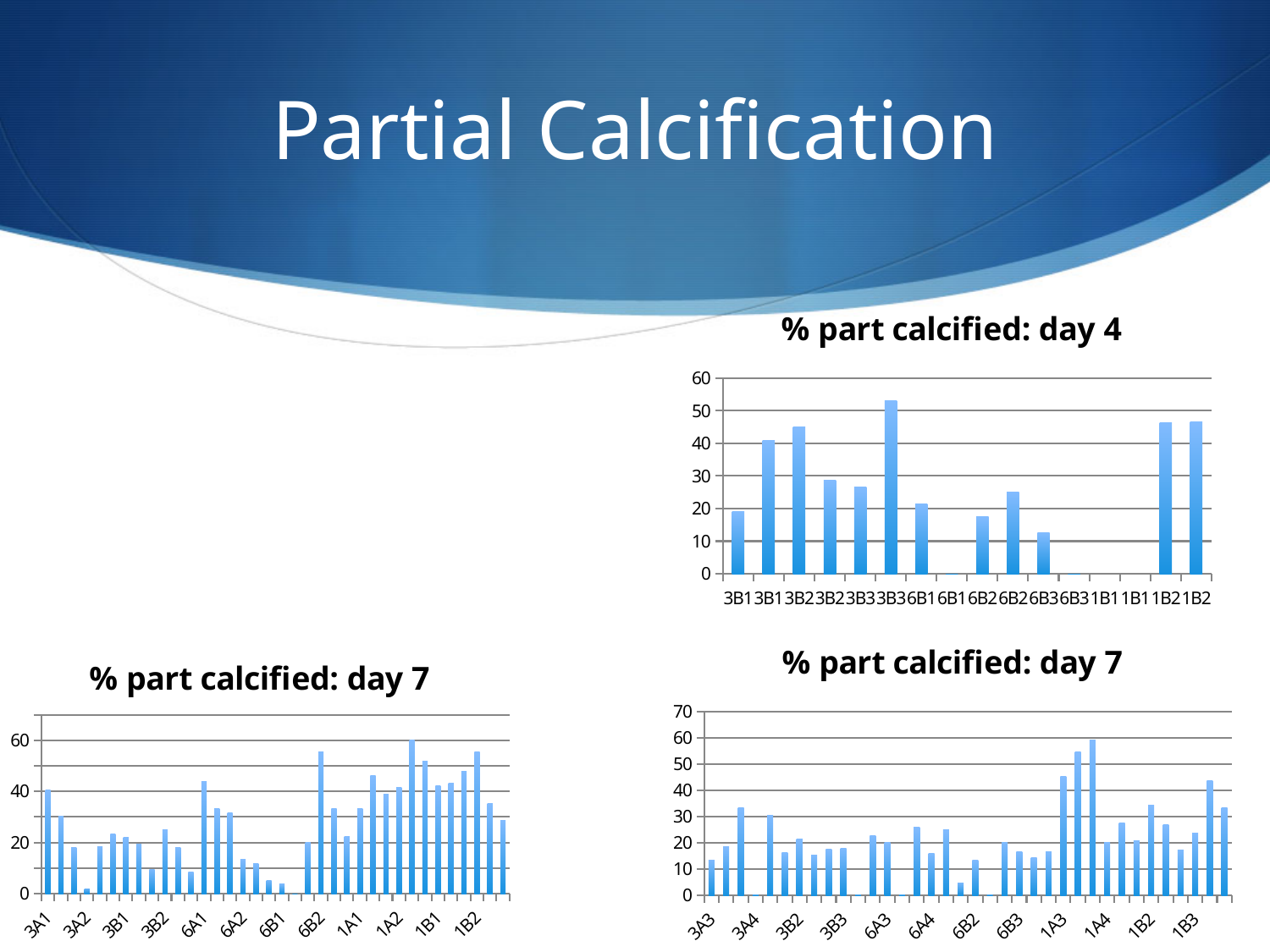
In the '% part calcified: day 4' chart, which category has the tallest bar? 3B3 In the bottom-left '% part calcified: day 7' chart, how many labels are shown on the x axis? 12 What kind of chart is the bottom-left '% part calcified: day 7' chart? bar chart In the bottom-right '% part calcified: day 7' chart, how many labels are shown on the x axis? 12 In the '% part calcified: day 4' chart, how many bars are plotted? 12 What is the title of the chart in the top right of the slide? % part calcified: day 4 In the '% part calcified: day 4' chart, is the first 3B1 bar greater or less than 30? less What kind of chart is the '% part calcified: day 4' chart in the top right? bar chart What is the highest value shown on the y axis of the '% part calcified: day 4' chart? 60 In the '% part calcified: day 4' chart, is the tallest bar greater or less than 50? greater In the bottom-right '% part calcified: day 7' chart, is the tallest bar greater or less than 50? greater